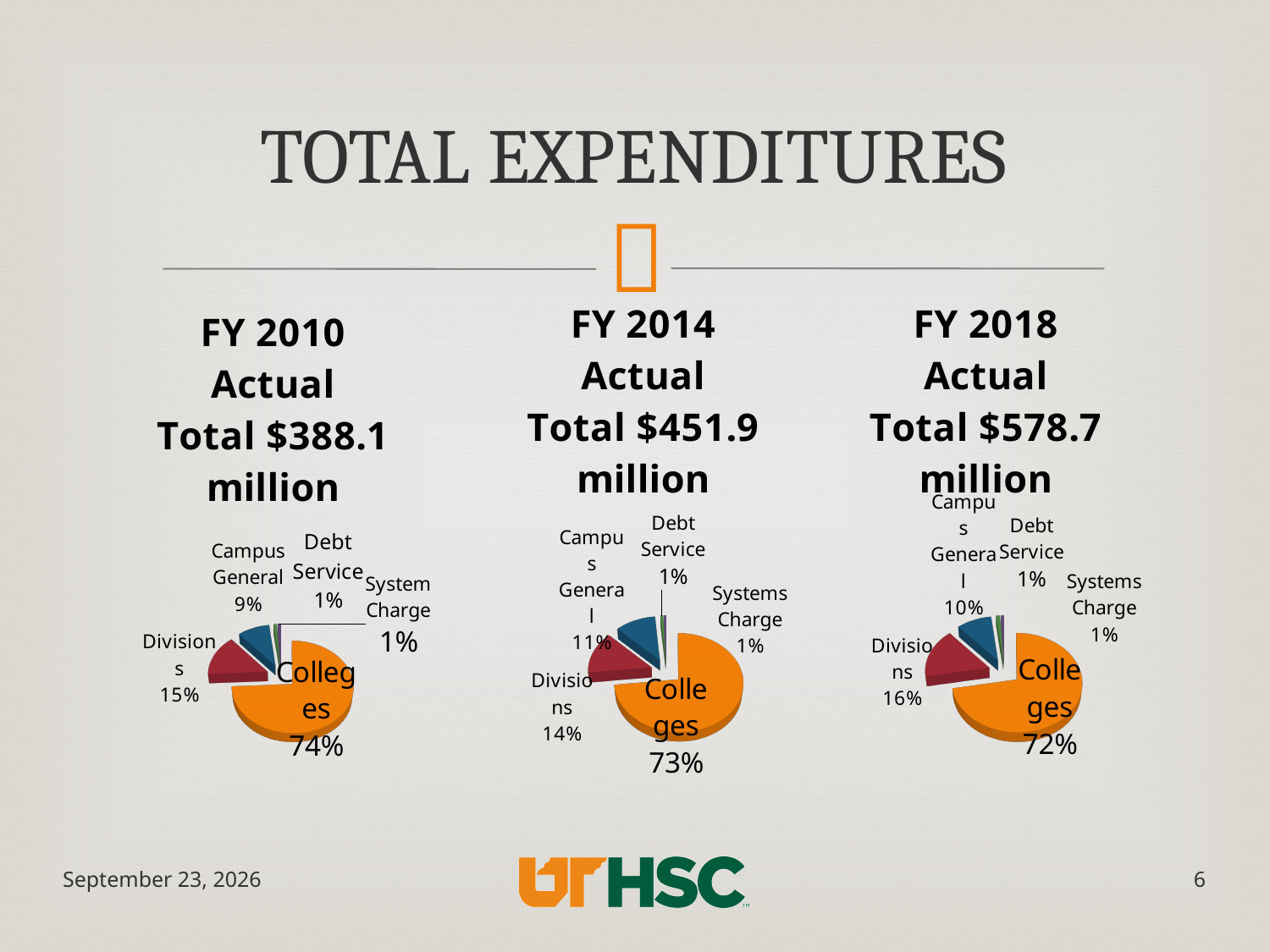
In the FY 2010 Actual pie chart, what share of expenditures goes to Colleges? 74% In the FY 2018 Actual pie chart, what percentage is shown for Debt Service? 1% What total expenditure amount is stated in the title of the FY 2014 Actual chart? $451.9 million What type of chart is used to show the FY 2014 Actual expenditures? Pie chart In the FY 2010 Actual pie chart, which is larger, Divisions or Campus General? Divisions In the FY 2018 Actual pie chart, what is the difference in percentage points between Divisions and Campus General? 6 In the FY 2018 Actual pie chart, what percentage is shown for Campus General? 10% In the FY 2010 Actual pie chart, what percentage is shown for System Charge? 1% In the FY 2018 Actual pie chart, which category has the largest share? Colleges In the FY 2014 Actual pie chart, what percentage is shown for Divisions? 14% How many slices does the FY 2010 Actual pie chart have? 5 In the FY 2014 Actual pie chart, what is the difference in percentage points between Colleges and Divisions? 59